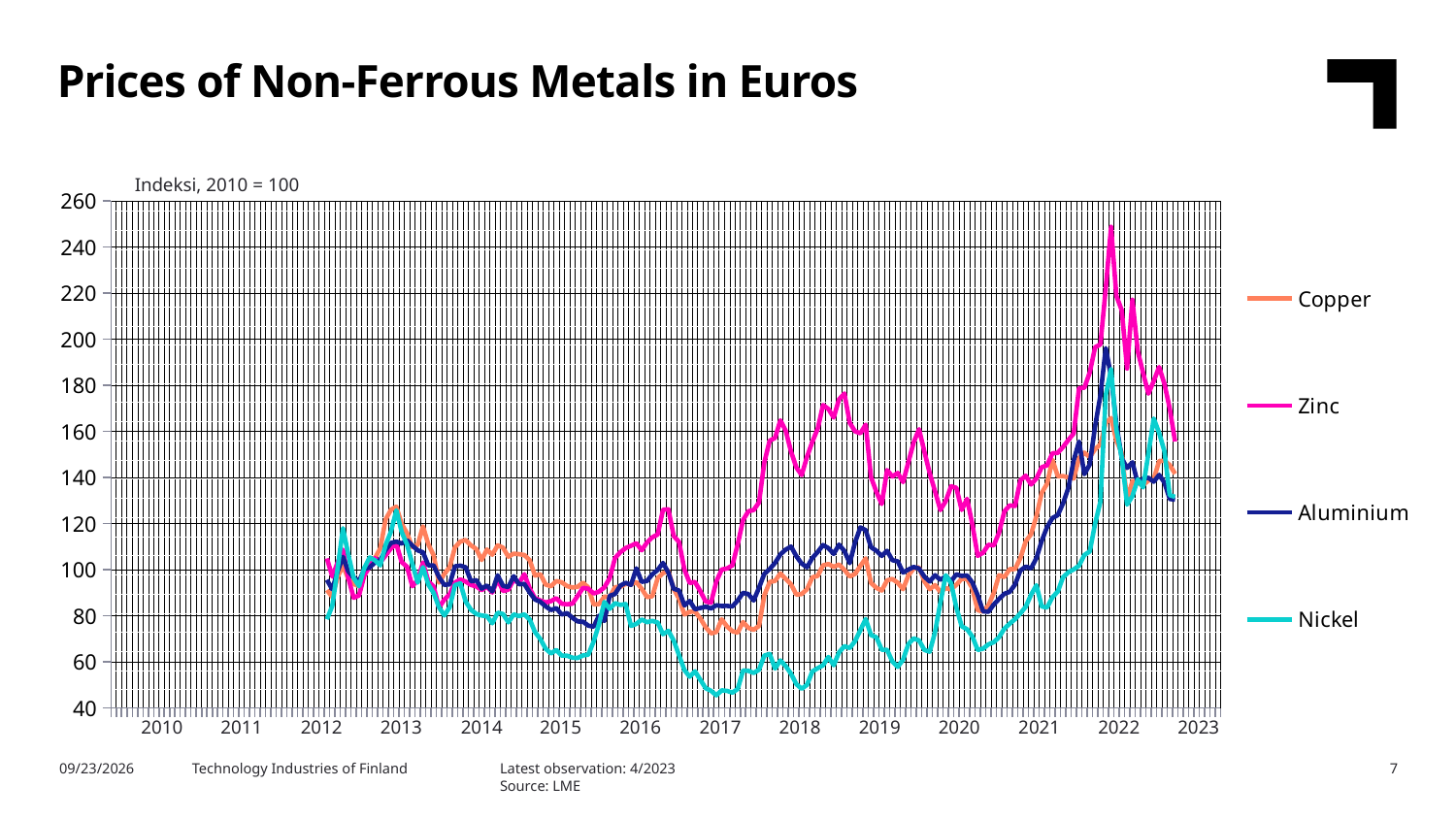
Which metals are listed in the chart legend? Copper, Zinc, Aluminium, Nickel Which series reaches the highest peak on the chart? Zinc What kind of chart is shown on the slide? Line chart Is the peak value for Aluminium in 2022 greater or less than 180? greater Which series is higher in mid-2018, Zinc or Nickel? Zinc Is the peak value for Zinc in 2022 greater or less than 220? greater Is the lowest value for Nickel in 2017 greater or less than 60? less What is the base year of the index used in the chart, as stated above the y axis? 2010 = 100 Which series has the lowest values during 2017? Nickel Does the Zinc series rise or fall between 2020 and early 2022? rise How many series does the legend list? 4